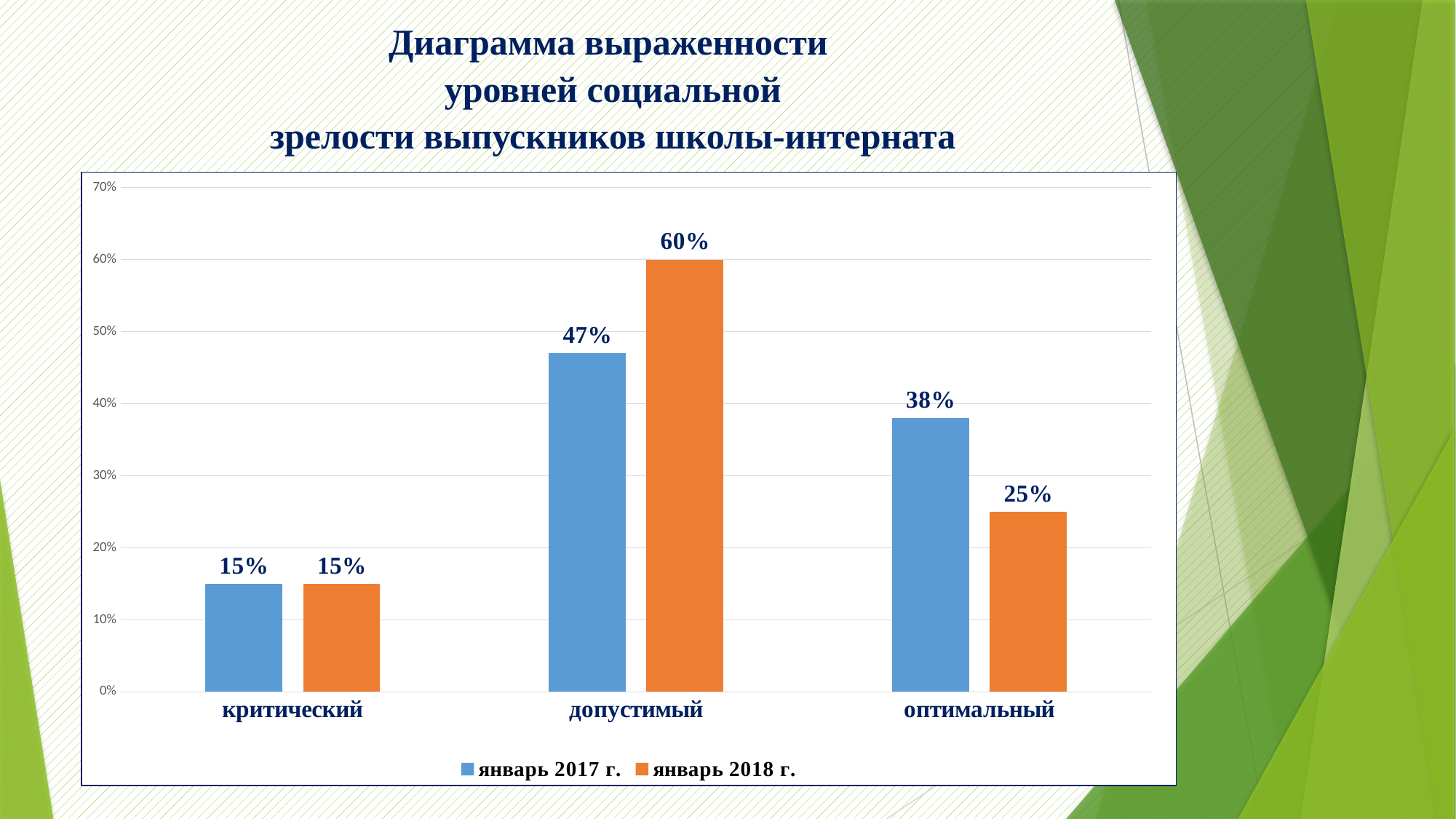
What is the value for "допустимый" in the "январь 2018 г." series? 60% For "оптимальный", which series has the larger value: "январь 2017 г." or "январь 2018 г."? январь 2017 г. What is the difference between the "январь 2018 г." and "январь 2017 г." values for "допустимый"? 13% What is the difference between the "январь 2017 г." and "январь 2018 г." values for "оптимальный"? 13% What is the value for "критический" in the "январь 2018 г." series? 15% What kind of chart is shown on the slide? bar chart Which category has the lowest value in the "январь 2017 г." series? критический Is the value for "допустимый" in the "январь 2017 г." series greater or less than 40%? greater What is the value for "оптимальный" in the "январь 2017 г." series? 38% How many categories are shown on the x axis? 3 Which category has the highest value in the "январь 2018 г." series? допустимый How many series does the legend list? 2